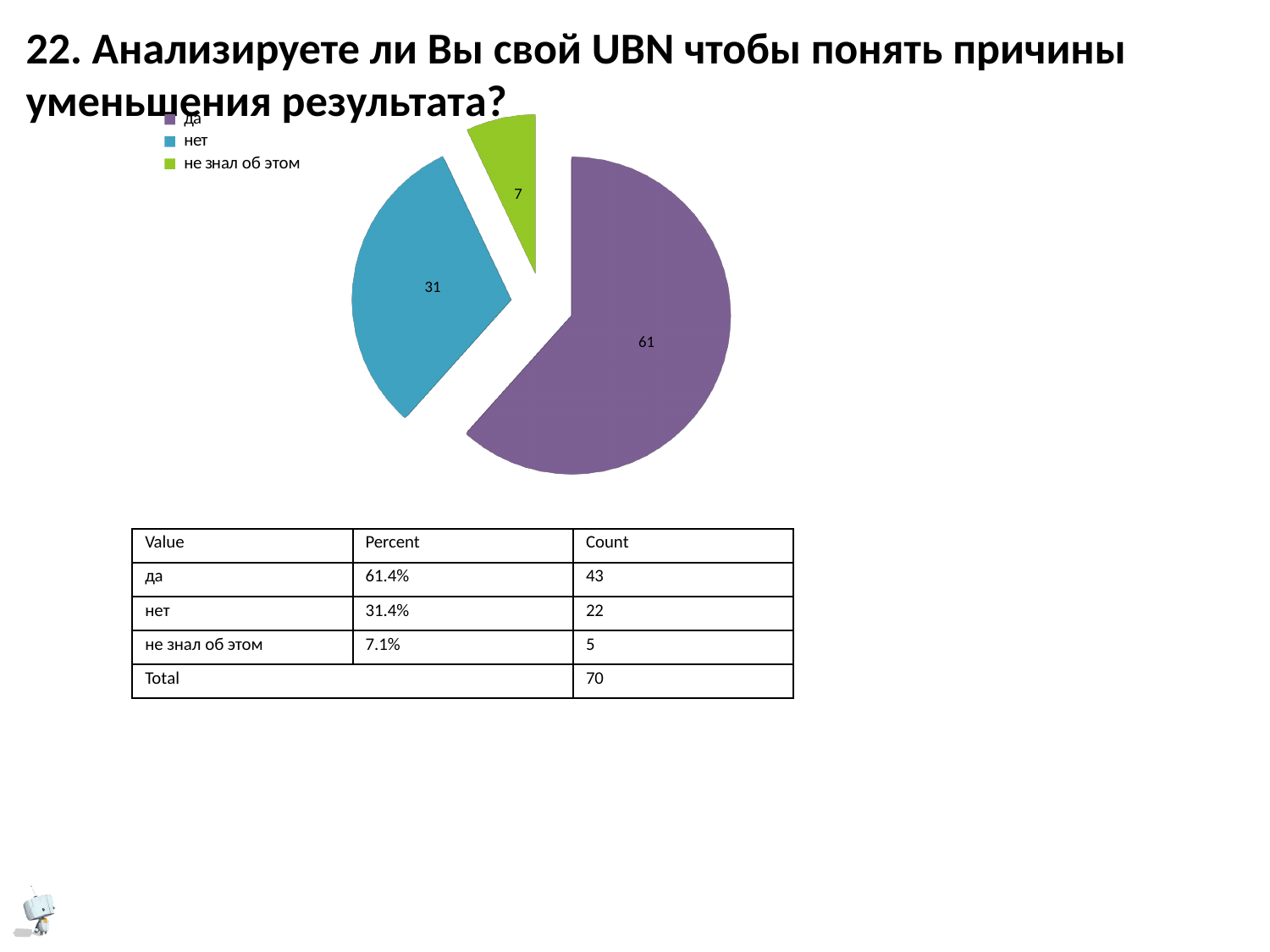
What value is labelled on the pie slice for "да"? 61 Which slice is larger in the pie chart, "нет" or "не знал об этом"? нет What is the difference between the labelled values for "да" and "нет" in the pie chart? 30 What colour is the slice for "да" in the pie chart? purple Which category has the smallest slice in the pie chart? не знал об этом How many slices does the pie chart have? 3 What value is labelled on the pie slice for "не знал об этом"? 7 What colour is the slice for "не знал об этом" in the pie chart? green Which category has the largest slice in the pie chart? да What value is labelled on the pie slice for "нет"? 31 What type of chart is shown on the slide? pie chart How many entries does the legend of the pie chart list? 3